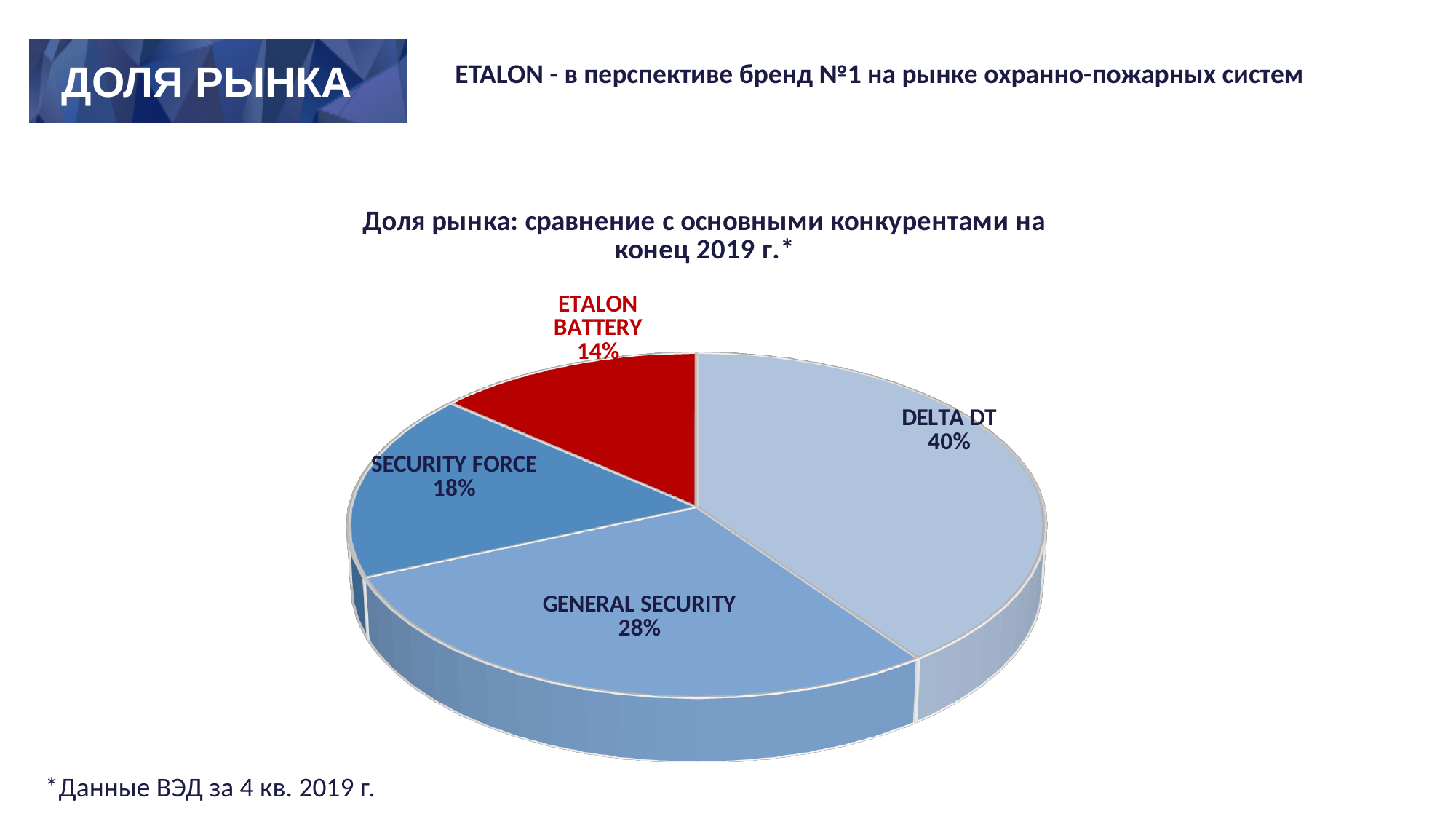
What is the difference in market share between DELTA DT and GENERAL SECURITY? 12% Which company has the smallest market share? ETALON BATTERY What is the title of the chart? Доля рынка: сравнение с основными конкурентами на конец 2019 г.* What is the market share of GENERAL SECURITY? 28% What is the market share of DELTA DT? 40% Which company has the largest market share? DELTA DT Which slice of the pie chart is coloured red? ETALON BATTERY What is the market share of SECURITY FORCE? 18% What type of chart is shown on the slide? pie chart Which has a larger market share, SECURITY FORCE or ETALON BATTERY? SECURITY FORCE What is the market share of ETALON BATTERY? 14% How many companies are shown in the pie chart? 4